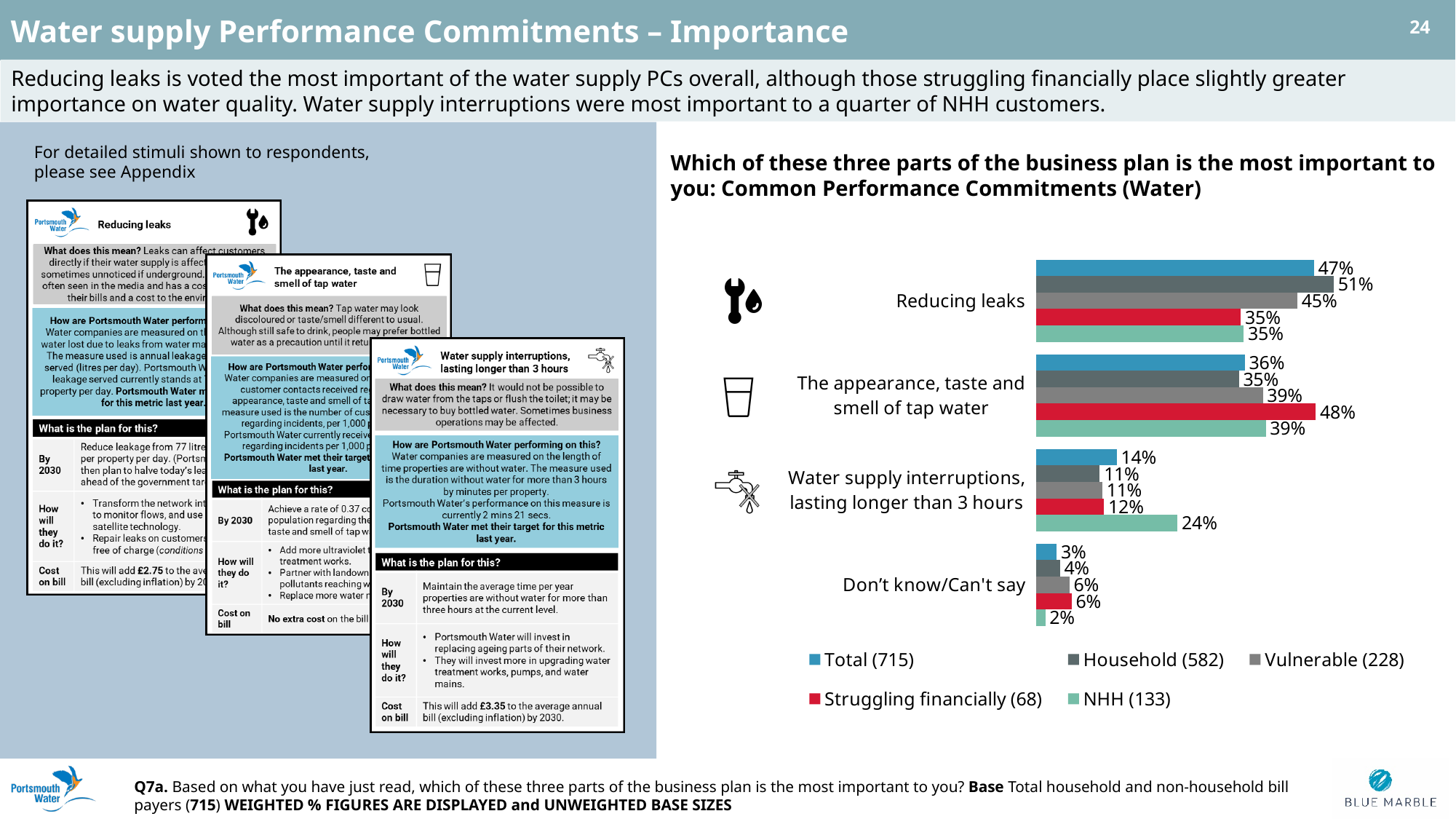
How many categories are plotted on the chart? 4 What is the difference between the Household (582) and Struggling financially (68) values for Reducing leaks? 16 percentage points How many series does the legend list? 5 What is the NHH (133) value for Water supply interruptions, lasting longer than 3 hours? 24% What is the Vulnerable (228) value for Don't know/Can't say? 6% For The appearance, taste and smell of tap water, which is larger: the Vulnerable (228) value or the Household (582) value? Vulnerable (228) Which series has the highest value for Reducing leaks? Household (582) What is the Struggling financially (68) value for The appearance, taste and smell of tap water? 48% What kind of chart is shown on the slide? Bar chart Which category has the lowest Total (715) value? Don't know/Can't say What is the base size shown in the legend for the NHH series? 133 What is the Total (715) value for Reducing leaks? 47%